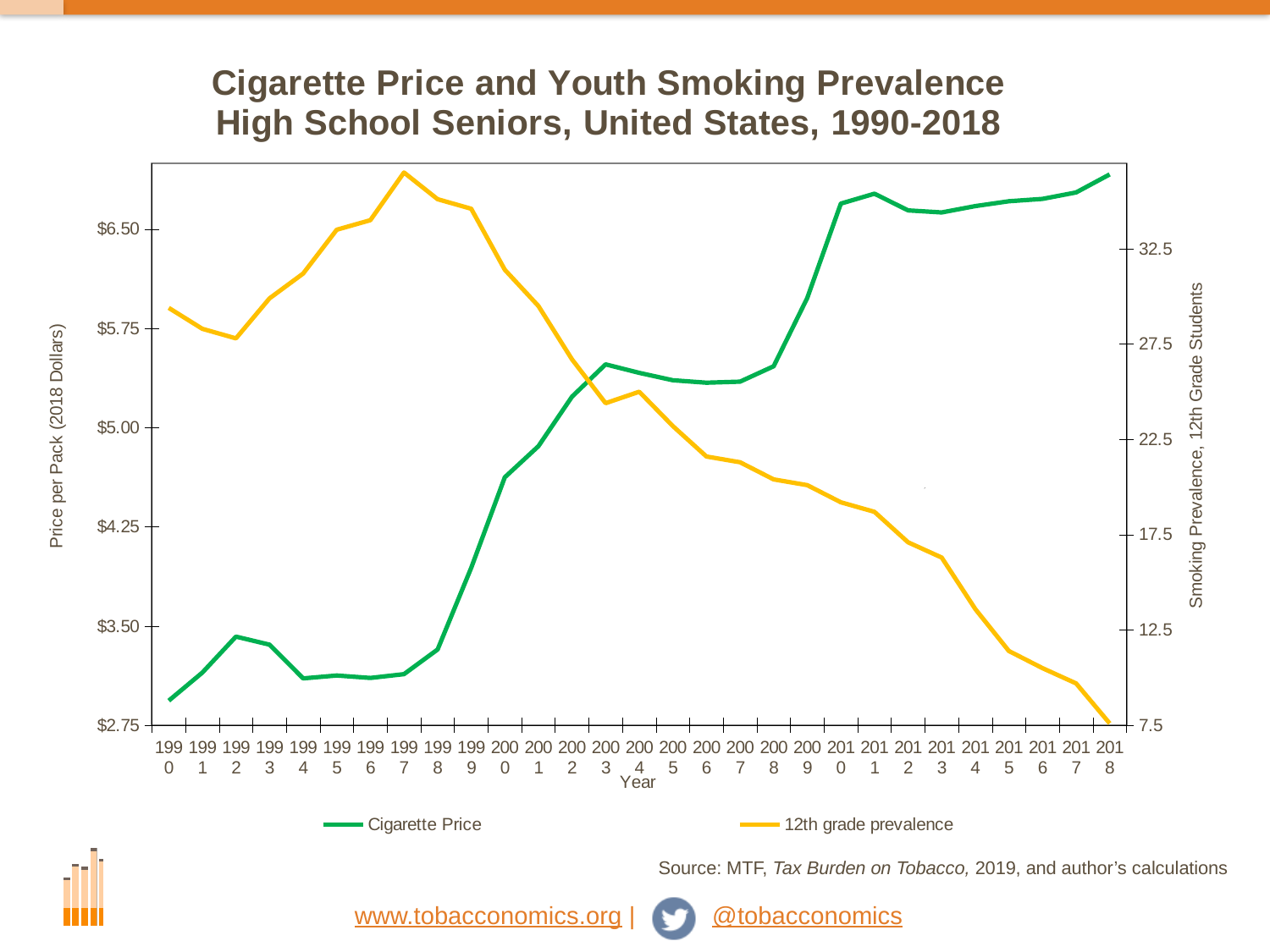
Is the Cigarette Price value for 1990 greater or less than $3.50? less Is the 12th grade prevalence value for 2018 greater or less than 12.5? less In which year is the Cigarette Price line at its highest? 2018 What kind of chart is shown on the slide? Line chart In which year does the 12th grade prevalence line reach its peak? 1997 In which year is the 12th grade prevalence line at its lowest? 2018 Overall, does the 12th grade prevalence line rise or fall from 1990 to 2018? fall How many series does the legend list? 2 Is the Cigarette Price value for 2018 greater or less than $6.50? greater How many years are plotted along the x axis? 29 In which year is the Cigarette Price line at its lowest? 1990 What is the label of the left vertical axis? Price per Pack (2018 Dollars)